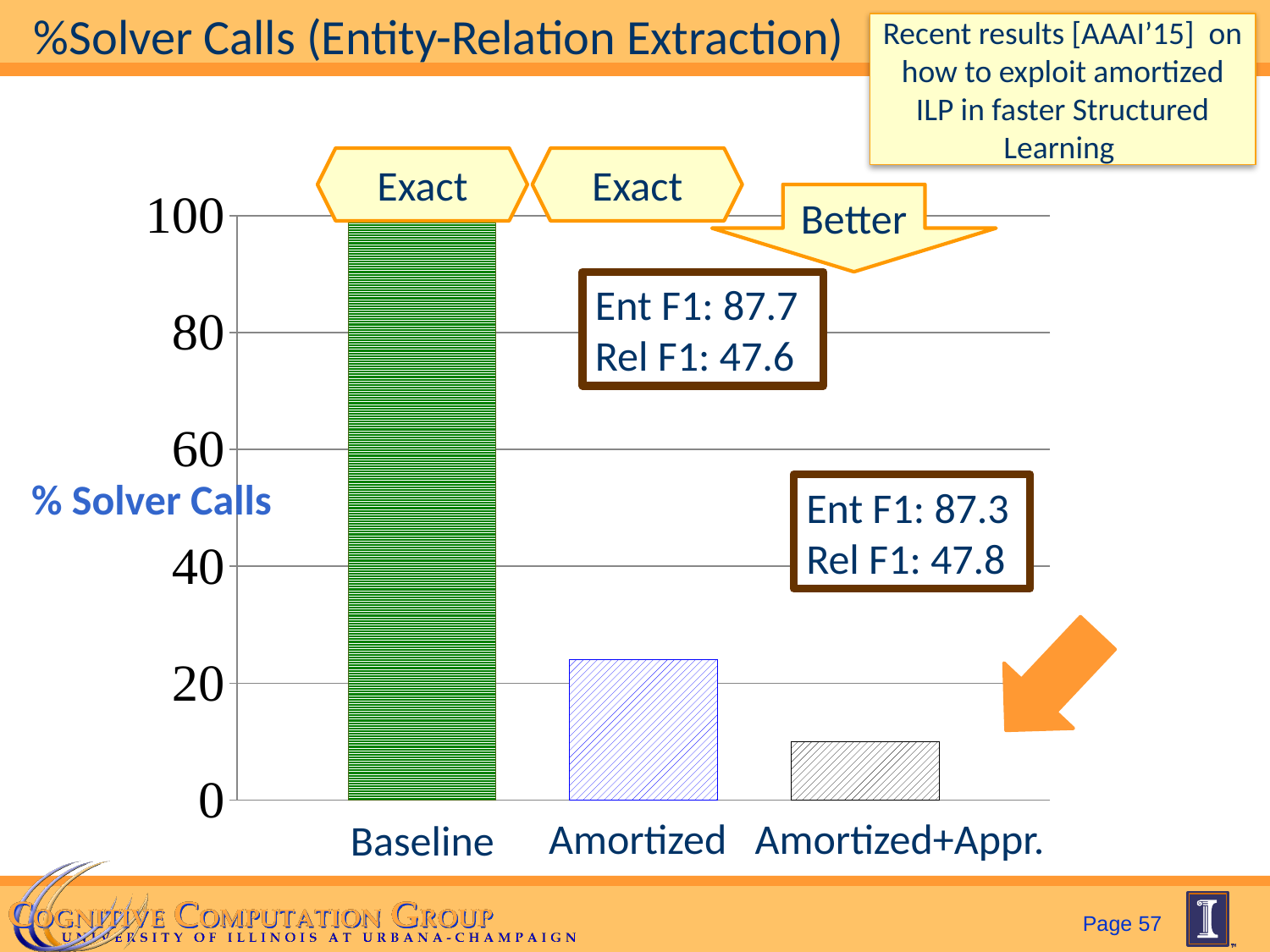
Which category has the highest % Solver Calls? Baseline What kind of chart is shown on the slide? bar chart Is the value for Amortized greater or less than 20? greater Is the value for Amortized+Appr. greater or less than 20? less Which has a larger % Solver Calls value, Amortized or Amortized+Appr.? Amortized What is the label on the vertical axis of the chart? % Solver Calls What is the title of the slide containing the chart? %Solver Calls (Entity-Relation Extraction) How many categories are shown on the x axis of the chart? 3 Do the bar values rise or fall from left to right across the x axis? fall What is the % Solver Calls value for Baseline? 100 Is the value for Amortized greater or less than 40? less Which category has the lowest % Solver Calls? Amortized+Appr.